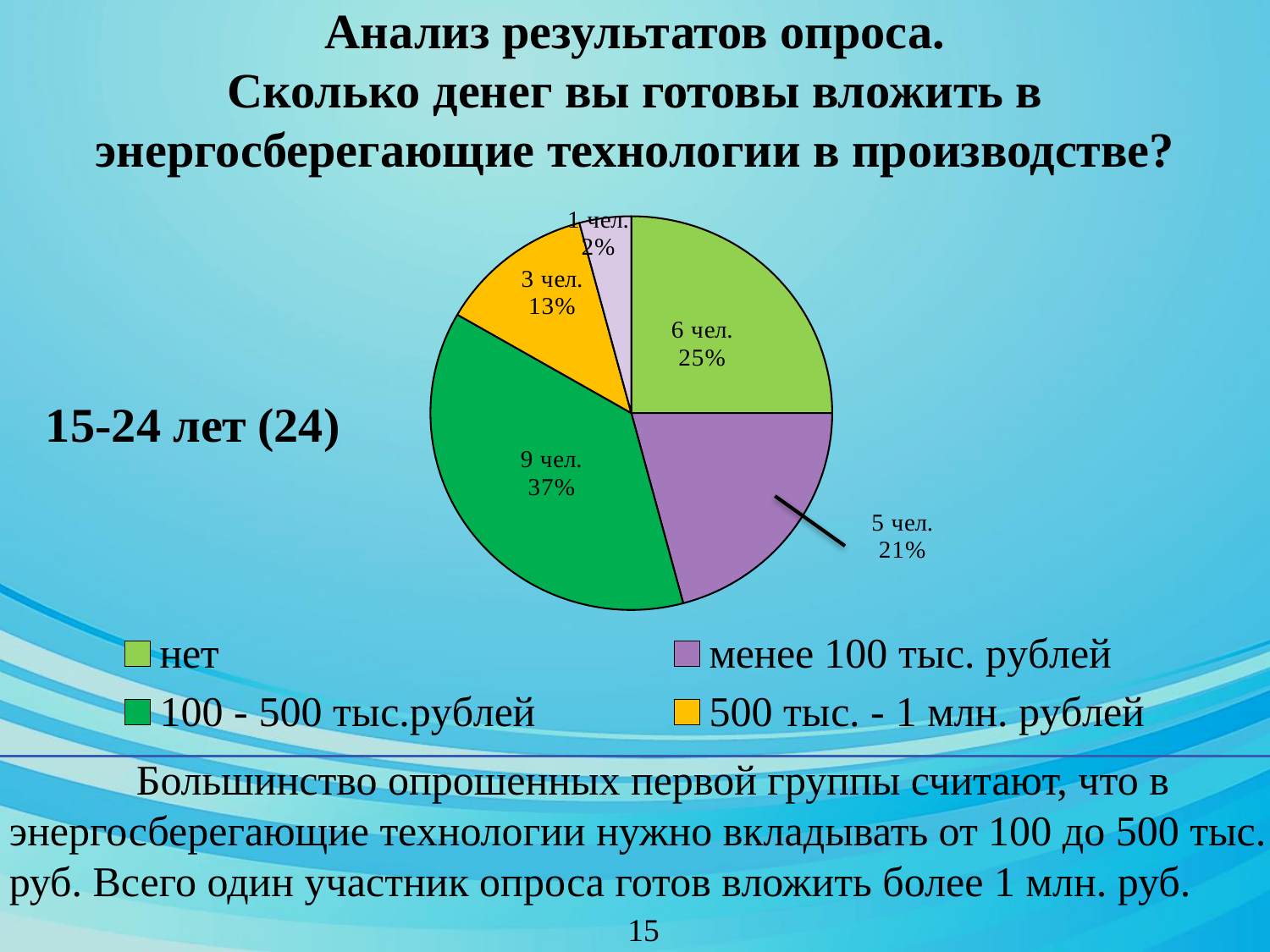
How many people chose "100 - 500 тыс.рублей"? 9 чел. What share of the pie does "нет" represent? 25% How many people chose "500 тыс. - 1 млн. рублей"? 3 чел. What colour is the slice for "500 тыс. - 1 млн. рублей"? yellow What kind of chart is shown on the slide? pie chart What percentage is shown for "менее 100 тыс. рублей"? 21% What is the smallest percentage shown on any slice of the pie? 2% How many entries does the legend list? 4 How many slices does the pie chart have? 5 How many more people chose "100 - 500 тыс.рублей" than "нет"? 3 Which category has the largest slice of the pie? 100 - 500 тыс.рублей Which is larger: the share for "нет" or the share for "менее 100 тыс. рублей"? нет